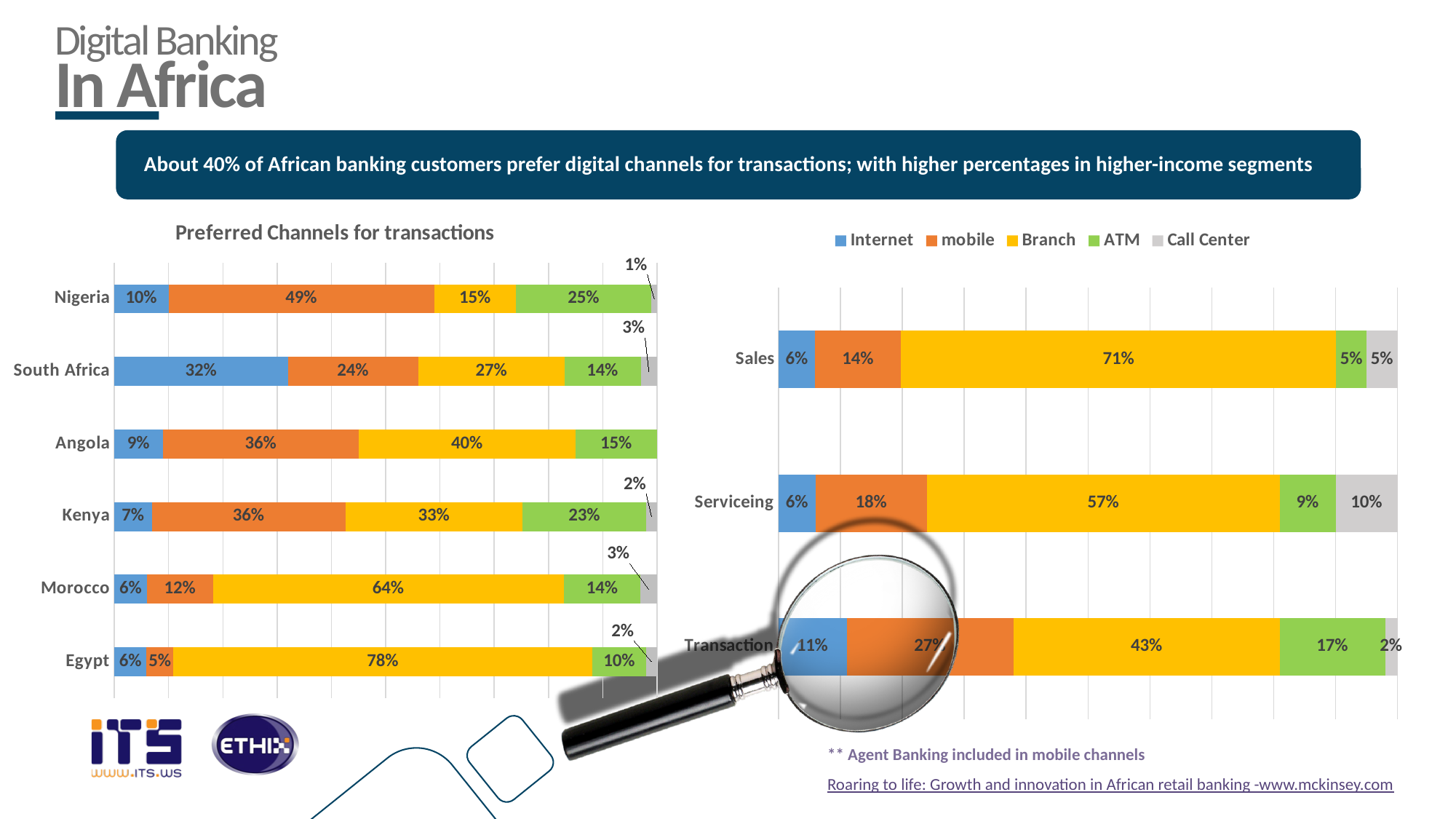
How many series does the legend list? 5 In the 'Preferred Channels for transactions' chart, is the ATM value larger for Kenya or for Morocco? Kenya In the 'Preferred Channels for transactions' chart, which country has the highest Internet percentage? South Africa In the right-hand chart, what is the Branch value for Sales? 71% In the 'Preferred Channels for transactions' chart, what is the difference between the Branch values for Morocco and Angola? 24% How many countries are shown in the 'Preferred Channels for transactions' chart? 6 In the right-hand chart, what is the Call Center value for Serviceing? 10% In the right-hand chart, which category has the highest mobile percentage? Transaction In the 'Preferred Channels for transactions' chart, which country has the lowest Branch percentage? Nigeria In the 'Preferred Channels for transactions' chart, what is the mobile value for Nigeria? 49% In the 'Preferred Channels for transactions' chart, what percentage of Egyptian customers prefer the Branch channel? 78% What type of chart is the 'Preferred Channels for transactions' chart? Stacked bar chart